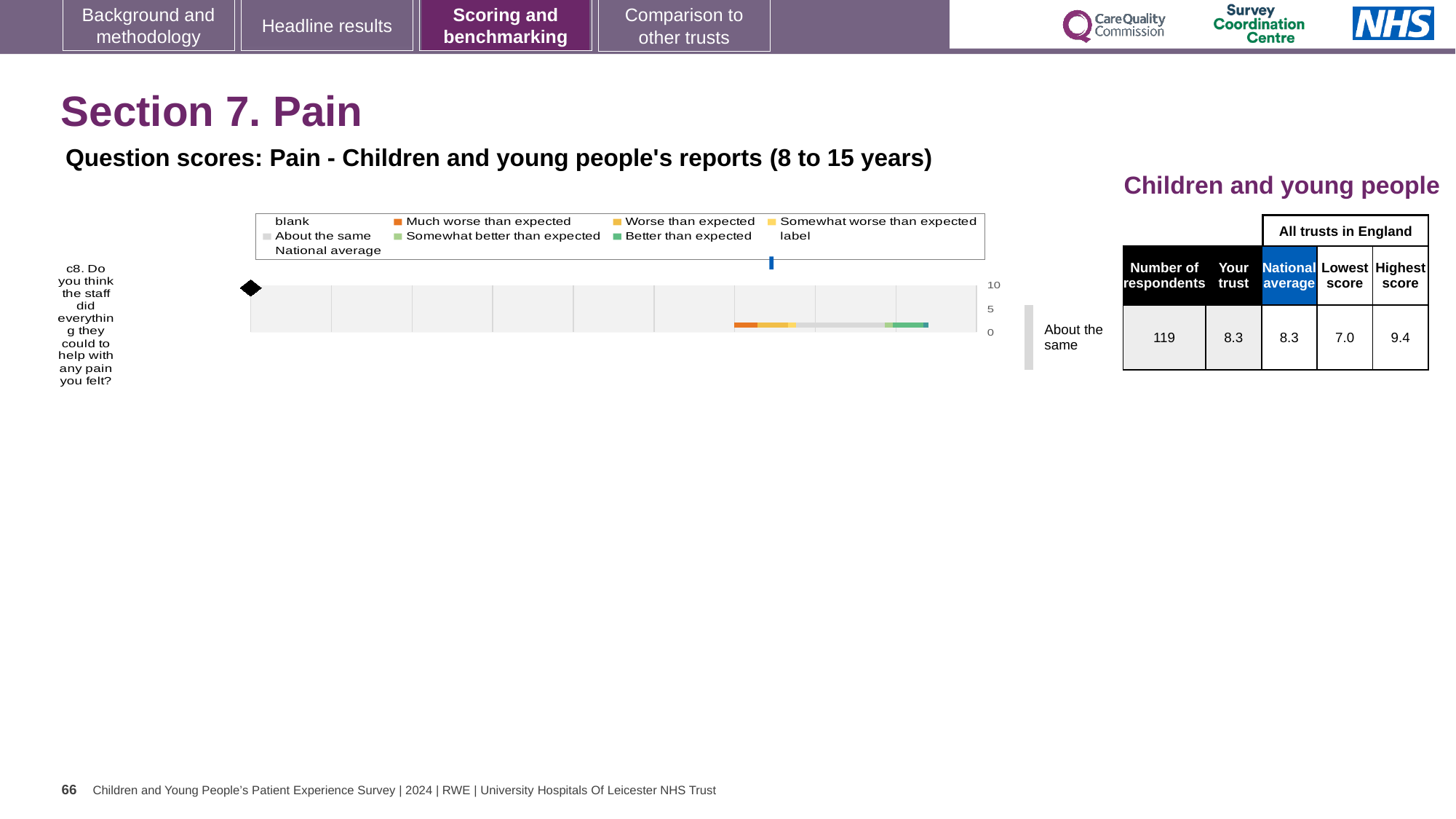
Which colour in the legend represents 'Much worse than expected'? orange What is the national average score for question c8? 8.3 How much higher is the trust's score for c8 than the lowest score in England? 1.3 What is the 'Your trust' score for question c8 about staff helping with pain? 8.3 What is the difference between the highest and lowest trust scores for question c8? 2.4 What type of chart is used to show the question score for c8? bar chart What is the highest score among all trusts in England for question c8? 9.4 Which benchmarking category is the trust's result for c8 placed in? About the same How many survey questions are plotted in the chart? 1 How many respondents answered question c8? 119 What is the highest tick value shown on the chart's score axis? 10 What is the lowest score among all trusts in England for question c8? 7.0